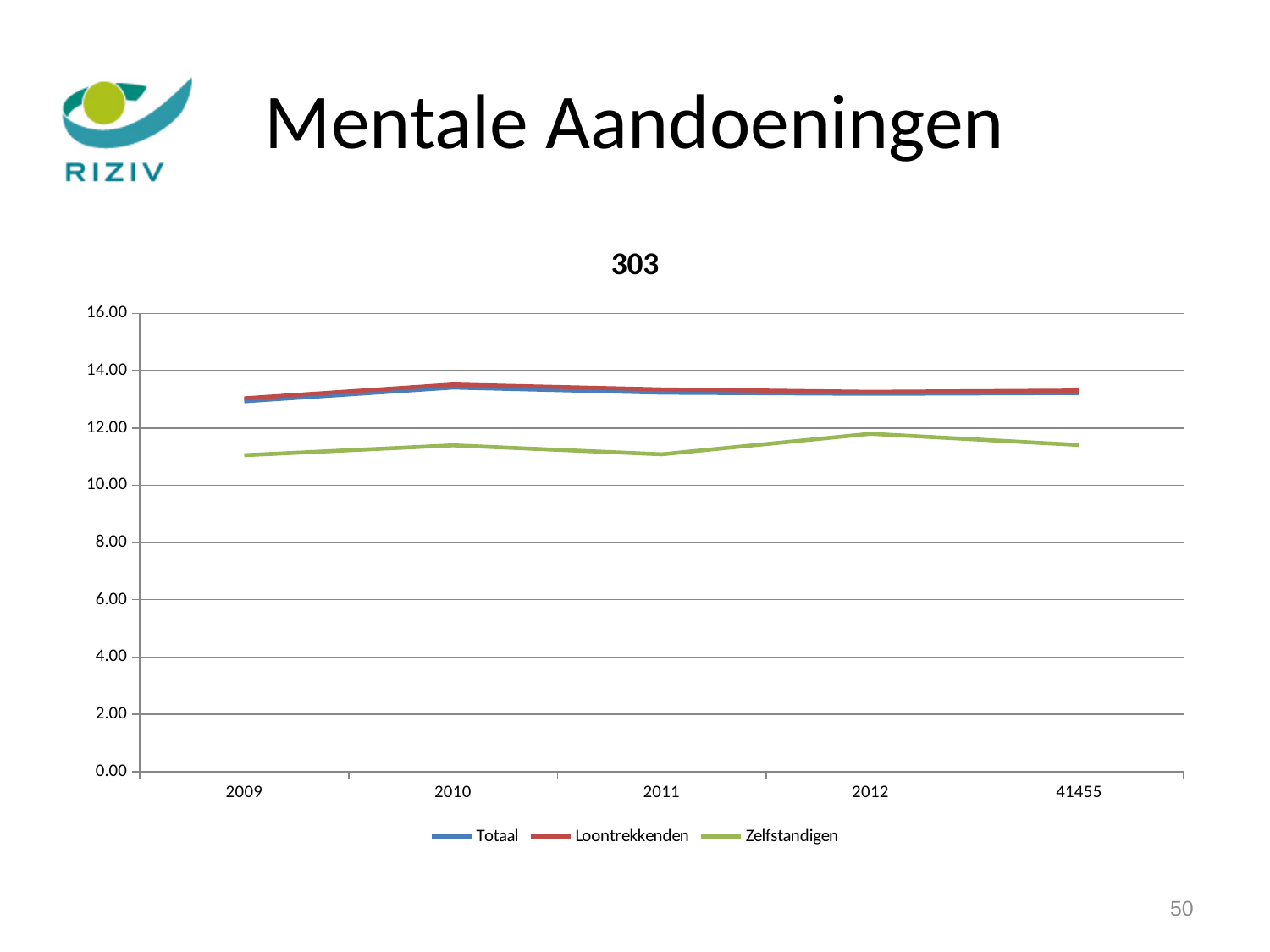
In which year is the Zelfstandigen line at its highest? 2012 Is the value for Zelfstandigen in 2009 greater or less than 12.00? less Is the value for Totaal in 2012 greater or less than 14.00? less Is the value for Loontrekkenden in 2010 greater or less than 12.00? greater In 2011, which is larger: the value for Loontrekkenden or the value for Zelfstandigen? Loontrekkenden What is the title of the chart? 303 How many points along the x axis does the chart have? 5 Which series is drawn in green in the legend? Zelfstandigen What kind of chart is shown on the slide? line chart In which year is the Loontrekkenden line at its highest? 2010 How many series does the legend list? 3